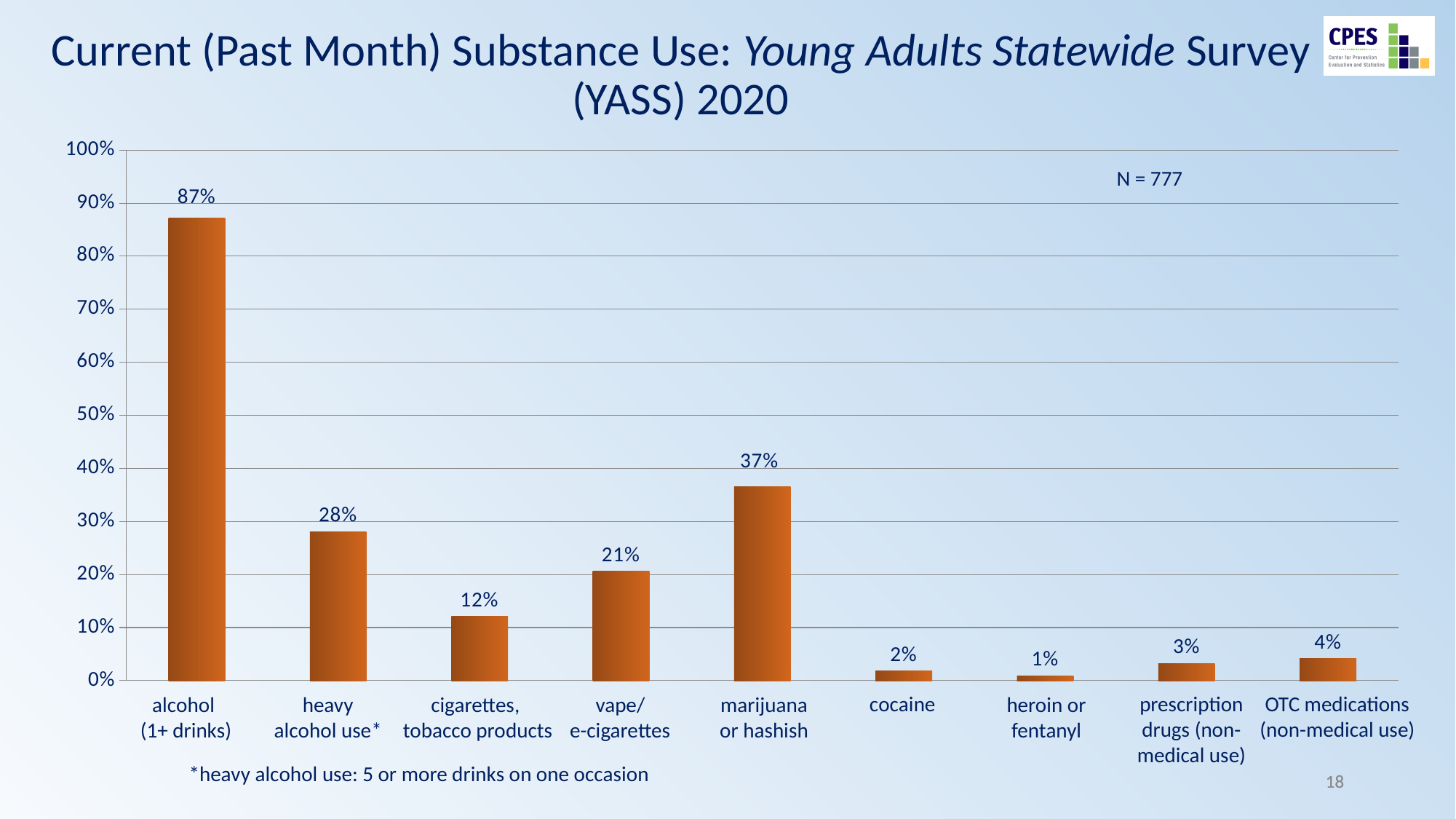
What type of chart is shown on the slide? bar chart What percentage is shown for vape/e-cigarettes? 21% What percentage of young adults reported current alcohol use (1+ drinks)? 87% How many substance categories are shown on the chart? 9 Which is larger: the value for cigarettes/tobacco products or the value for vape/e-cigarettes? vape/e-cigarettes What is the value for heroin or fentanyl? 1% Which substance has the highest current use percentage? alcohol (1+ drinks) What is the difference between the percentages for alcohol (1+ drinks) and heavy alcohol use? 59% What is the value shown for marijuana or hashish? 37% What sample size (N) is noted on the chart? N = 777 Is the value for marijuana or hashish greater or less than 30%? greater Which substance has the lowest current use percentage? heroin or fentanyl